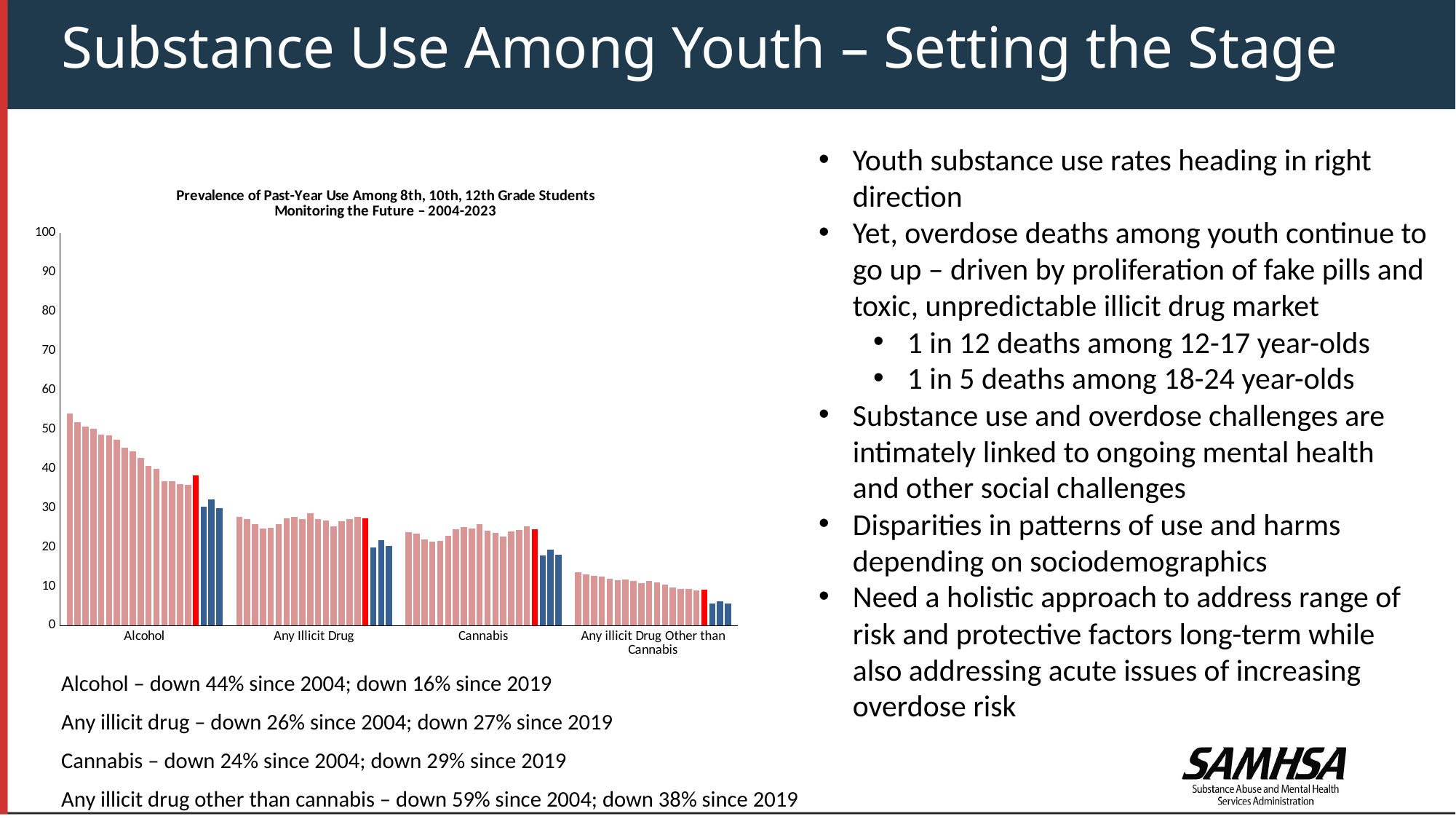
Are the bars for Any illicit Drug Other than Cannabis greater or less than 20? less How many substance categories are shown along the x axis of the chart? 4 Is the last (rightmost) Alcohol bar greater or less than 40? less Which substance category has the highest bars in the chart? Alcohol Is the tallest Alcohol bar greater or less than 50? greater What kind of chart is shown on the slide? bar chart Which substance category has the lowest bars in the chart? Any illicit Drug Other than Cannabis Within the Alcohol group, do the bars generally rise or fall from left to right? fall What is the title of the chart? Prevalence of Past-Year Use Among 8th, 10th, 12th Grade Students Monitoring the Future – 2004-2023 What is the maximum value shown on the chart's y axis? 100 Which is larger, the first Alcohol bar or the first Cannabis bar? the first Alcohol bar